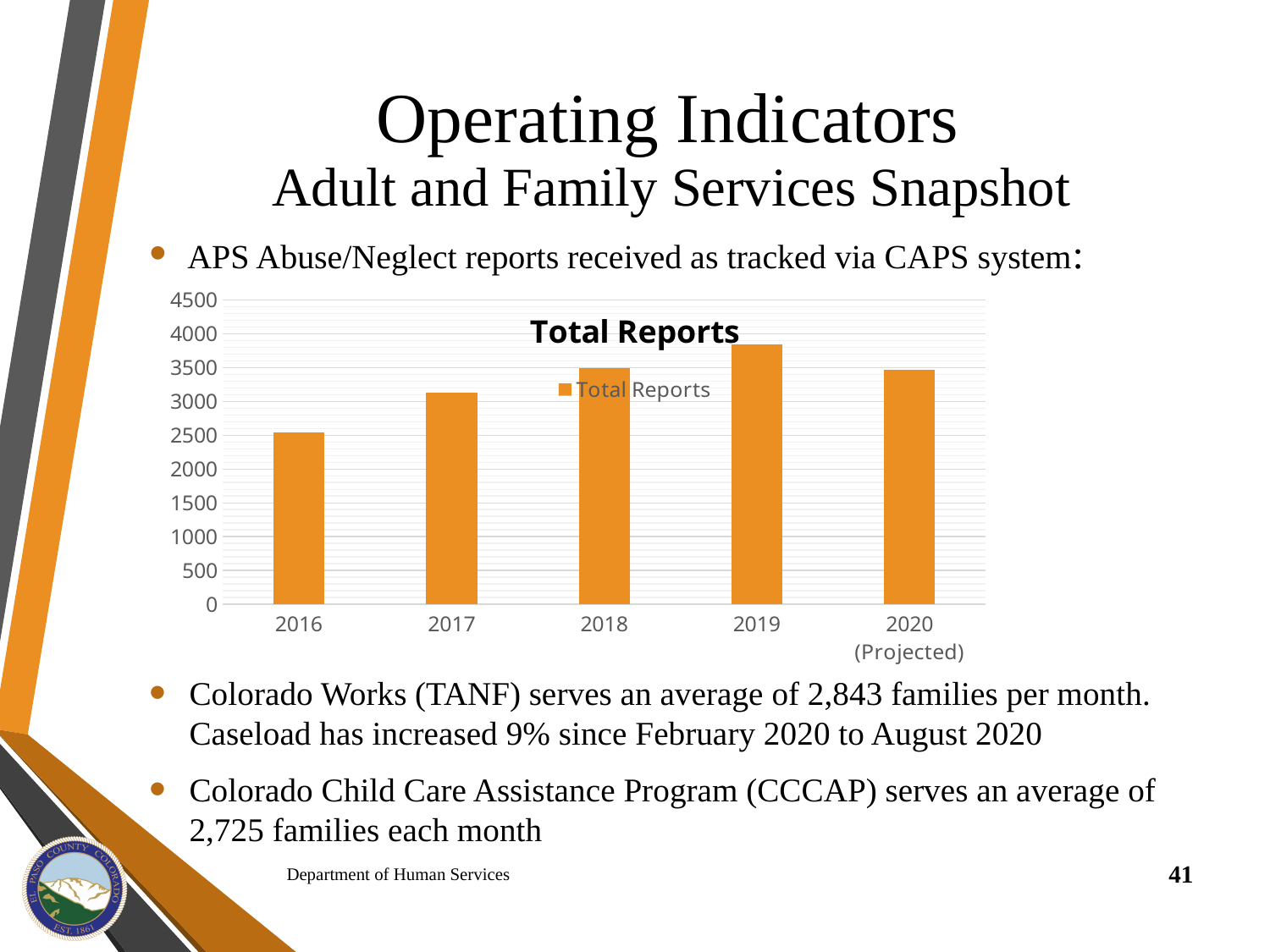
What kind of chart is shown on the slide? bar chart Is the value for 2020 (Projected) greater or less than 3000? greater What is the title of the chart? Total Reports Which year has the lowest number of total reports? 2016 How many years (categories) are shown on the x axis of the chart? 5 Is the value for 2019 greater or less than 4000? less Is the value for 2017 greater or less than 3000? greater Which year has more total reports, 2016 or 2019? 2019 How many series does the chart legend list? 1 Which year has the highest number of total reports? 2019 Do the total reports rise or fall from 2016 to 2019? rise